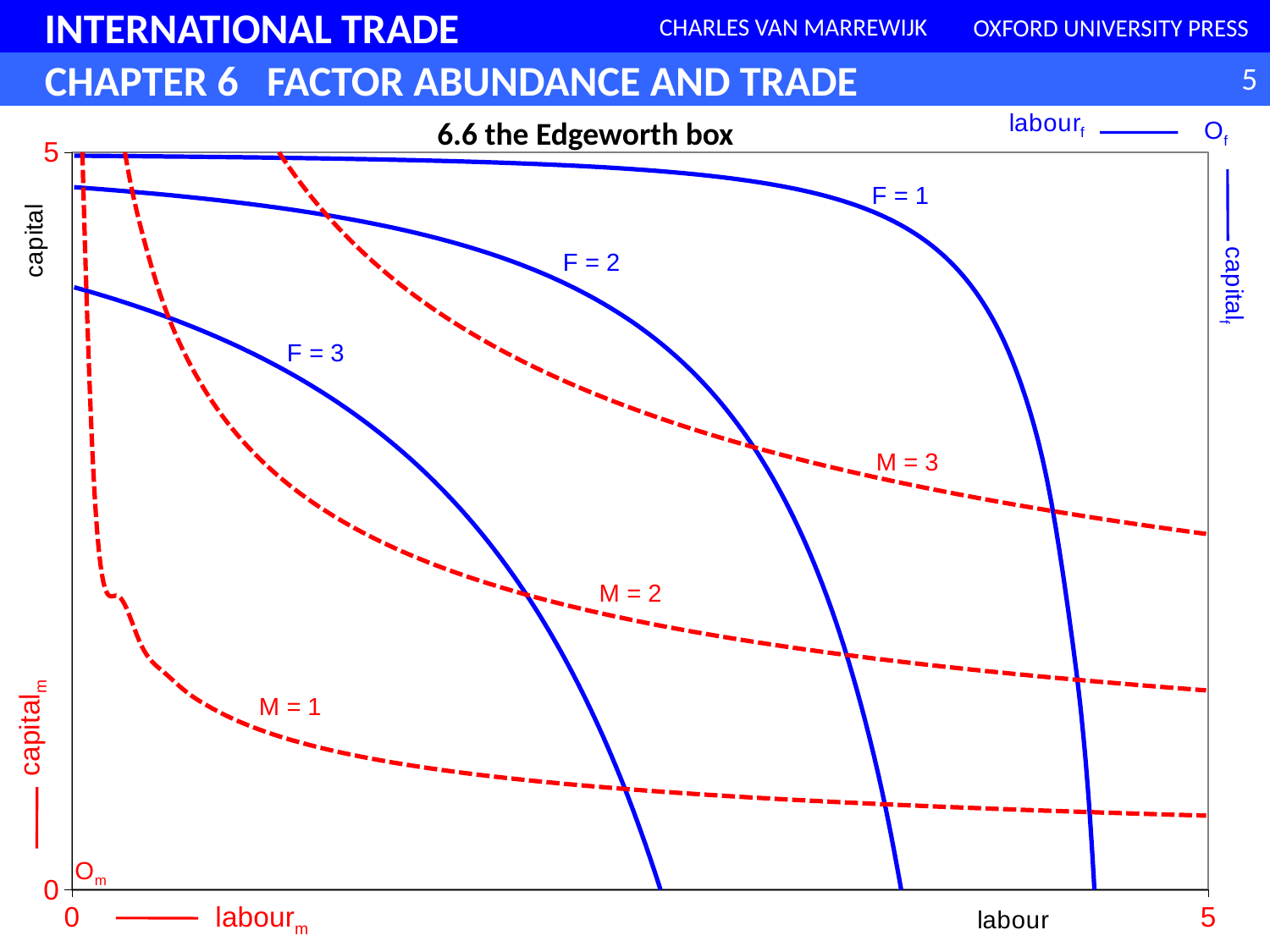
How many M isoquants (dashed curves) are drawn in the Edgeworth box? 3 What is the title of the chart on the slide? 6.6 the Edgeworth box Which curve lies higher in the box, F = 1 or F = 3? F = 1 How many F isoquants (solid curves) are drawn in the Edgeworth box? 3 What is the maximum value shown on the labour axis of the Edgeworth box? 5 What is the maximum value shown on the capital axis of the Edgeworth box? 5 How many curves in total are plotted in the Edgeworth box? 6 What kind of chart is shown in '6.6 the Edgeworth box'? line chart Moving from left to right along the labour axis, does the F = 1 curve rise or fall? fall What colour and line style are used for the M isoquants? red dashed Which curve lies higher in the box, M = 3 or M = 1? M = 3 Moving from left to right along the labour axis, does the M = 1 curve rise or fall? fall